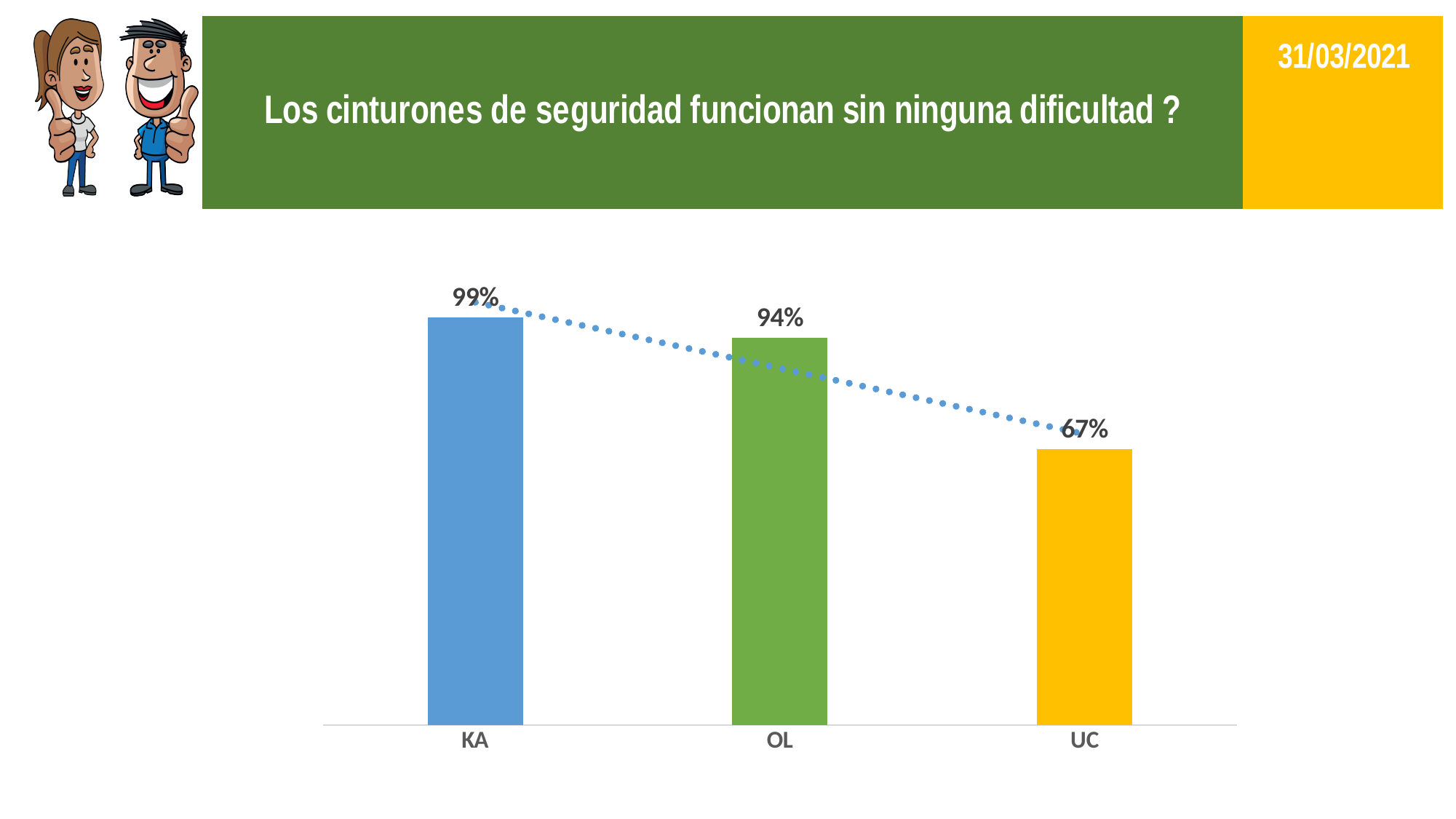
Which is larger, the value for OL or the value for UC? OL What is the value for UC? 67% What is the difference between the values for KA and OL? 5% What is the value for KA? 99% What colour is the bar for UC? Yellow Do the values rise or fall from KA to UC along the x axis? Fall What is the difference between the values for KA and UC? 32% Which category has the highest value? KA What is the value for OL? 94% How many categories are shown on the x axis? 3 What kind of chart is shown on the slide? Bar chart Which category has the lowest value? UC